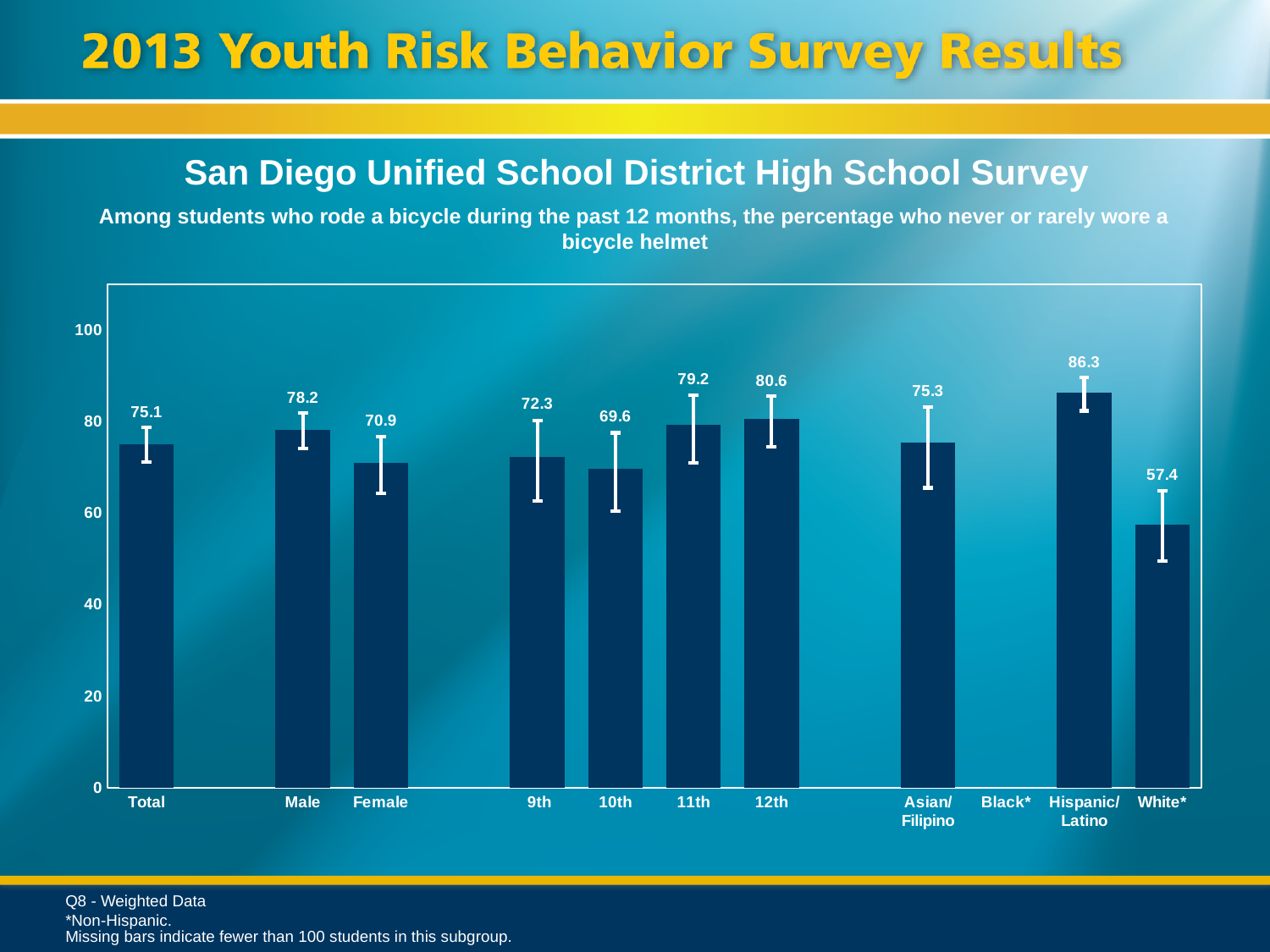
Which category has the highest value? Hispanic/Latino Do the values rise or fall from 10th to 12th grade? rise Which category on the x axis has no bar plotted? Black* What is the value for Female? 70.9 Is the value for White* greater or less than 60? less Which is larger, the value for 9th or the value for 10th? 9th What kind of chart is shown? bar chart What is the difference between the values for Male and Female? 7.3 What is the value for 12th? 80.6 How many categories have a plotted bar? 10 What is the value for Total? 75.1 Which category with a plotted bar has the lowest value? White*